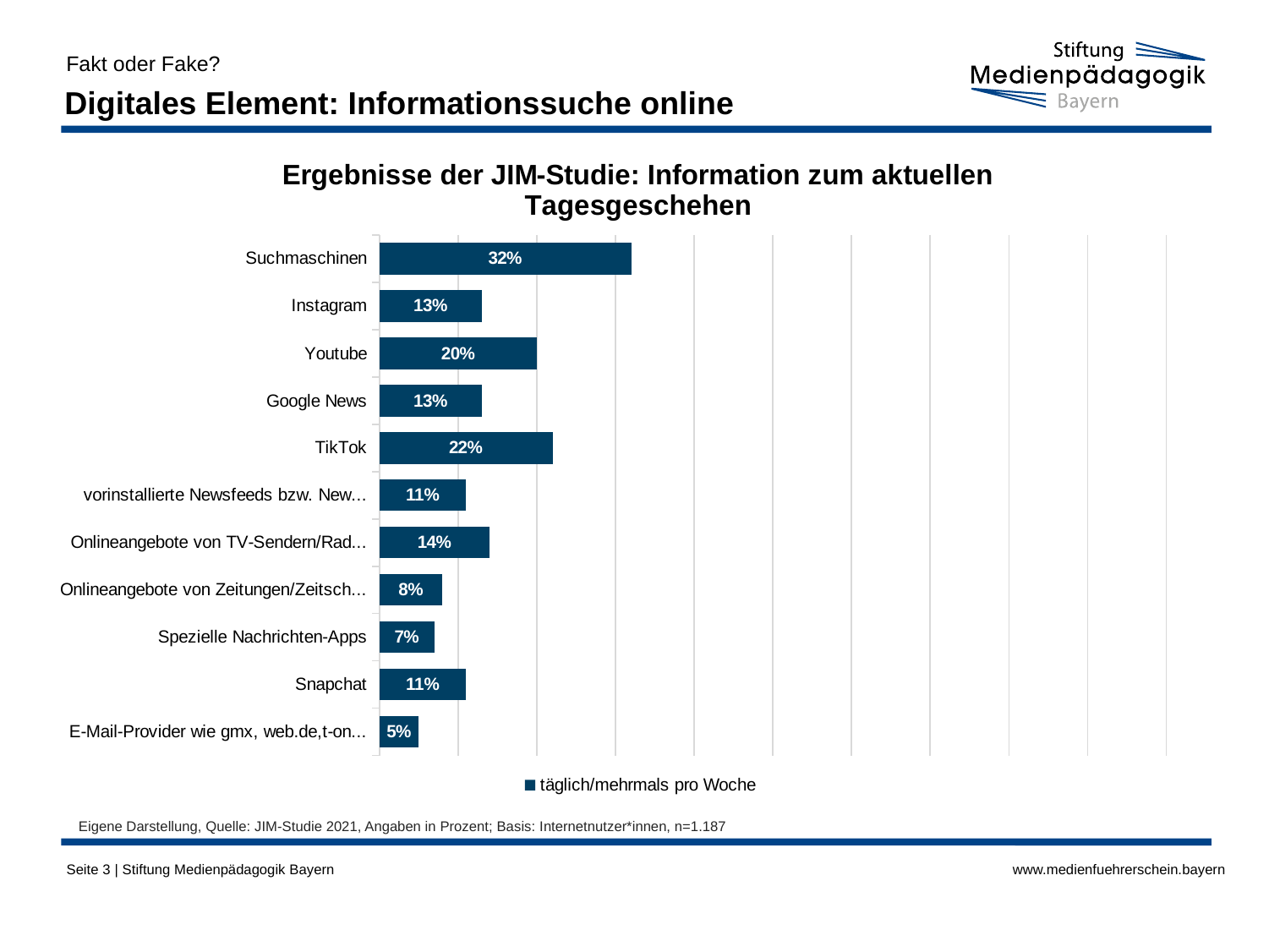
How many categories are shown in the chart? 11 What is the legend entry of the chart? täglich/mehrmals pro Woche Which category has the lowest value? E-Mail-Provider wie gmx, web.de,t-on... What is the value for Spezielle Nachrichten-Apps? 7% What is the difference between the values for Suchmaschinen and Youtube? 12% Which category has the highest value? Suchmaschinen Which is larger, the value for TikTok or the value for Youtube? TikTok What is the value for Suchmaschinen? 32% What is the value for TikTok? 22% What kind of chart is shown on the slide? Bar chart What is the value for Snapchat? 11% How many series does the legend list? 1